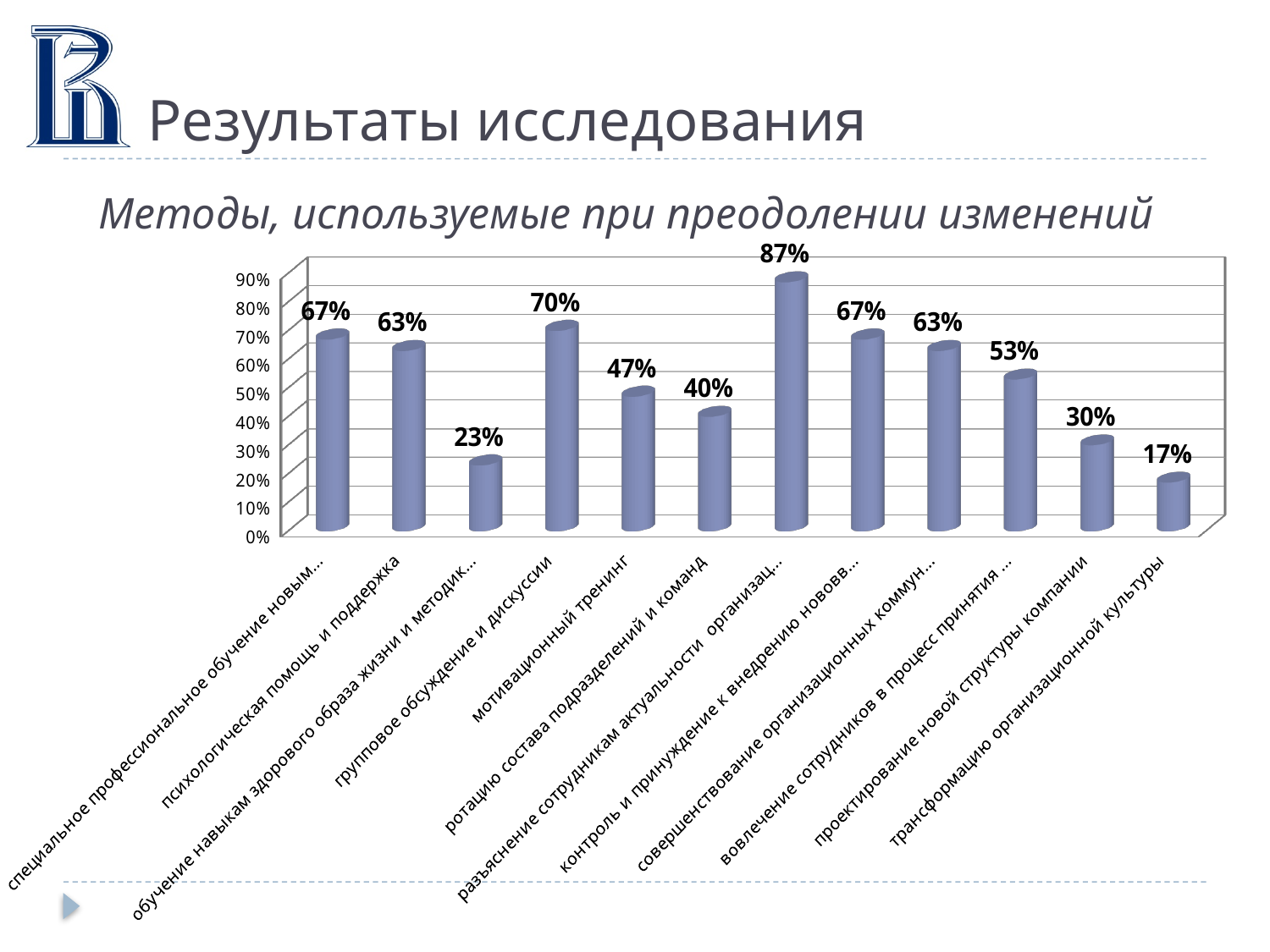
Which category has the lowest value? трансформацию организационной культуры Which is larger: the value for "ротацию состава подразделений и команд" or for "проектирование новой структуры компании"? ротацию состава подразделений и команд How many categories are plotted on the chart? 12 What is the title of the chart? Методы, используемые при преодолении изменений What kind of chart is shown on the slide? bar chart What value is shown for "проектирование новой структуры компании"? 30% What value is shown for "групповое обсуждение и дискуссии"? 70% What value is shown for "мотивационный тренинг"? 47% What is the difference between the values for "групповое обсуждение и дискуссии" and "мотивационный тренинг"? 23% What is the difference between the values for "психологическая помощь и поддержка" and "трансформацию организационной культуры"? 46% What is the highest value shown on the chart? 87% What value is shown for "психологическая помощь и поддержка"? 63%